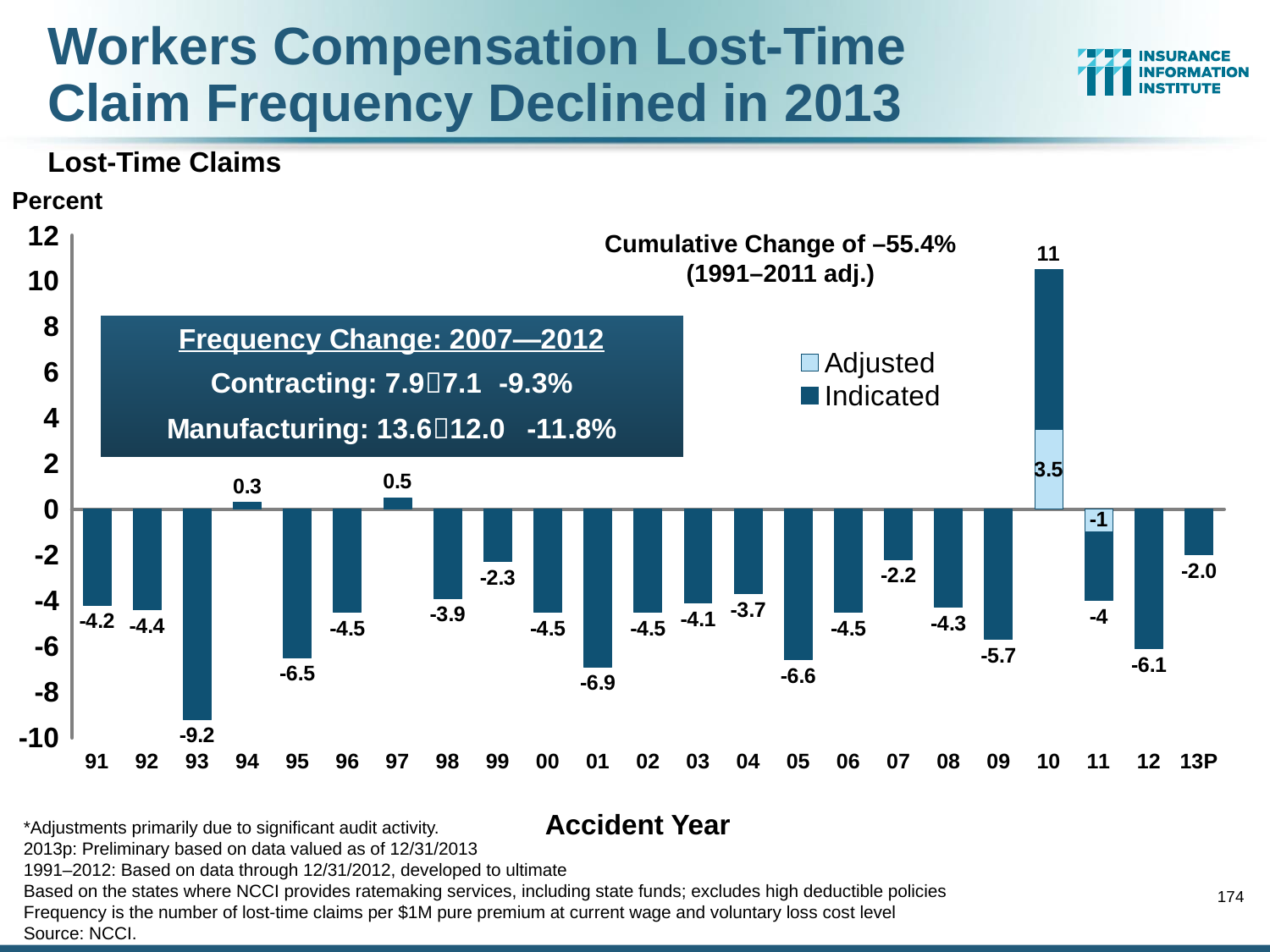
Which accident year has the lowest value? 93 What kind of chart is shown on the slide? Bar chart What is the difference between the values for accident years 12 and 13P? 4.1 Which accident year has the highest value? 10 What is the value for accident year 93? -9.2 Which is larger, the value for accident year 94 or accident year 97? 97 How many series does the legend list? 2 What is the Indicated value for accident year 10? 11 What is the value for accident year 01? -6.9 What is the value for accident year 13P? -2.0 What is the Adjusted value for accident year 10? 3.5 How many accident years are shown on the x axis? 23